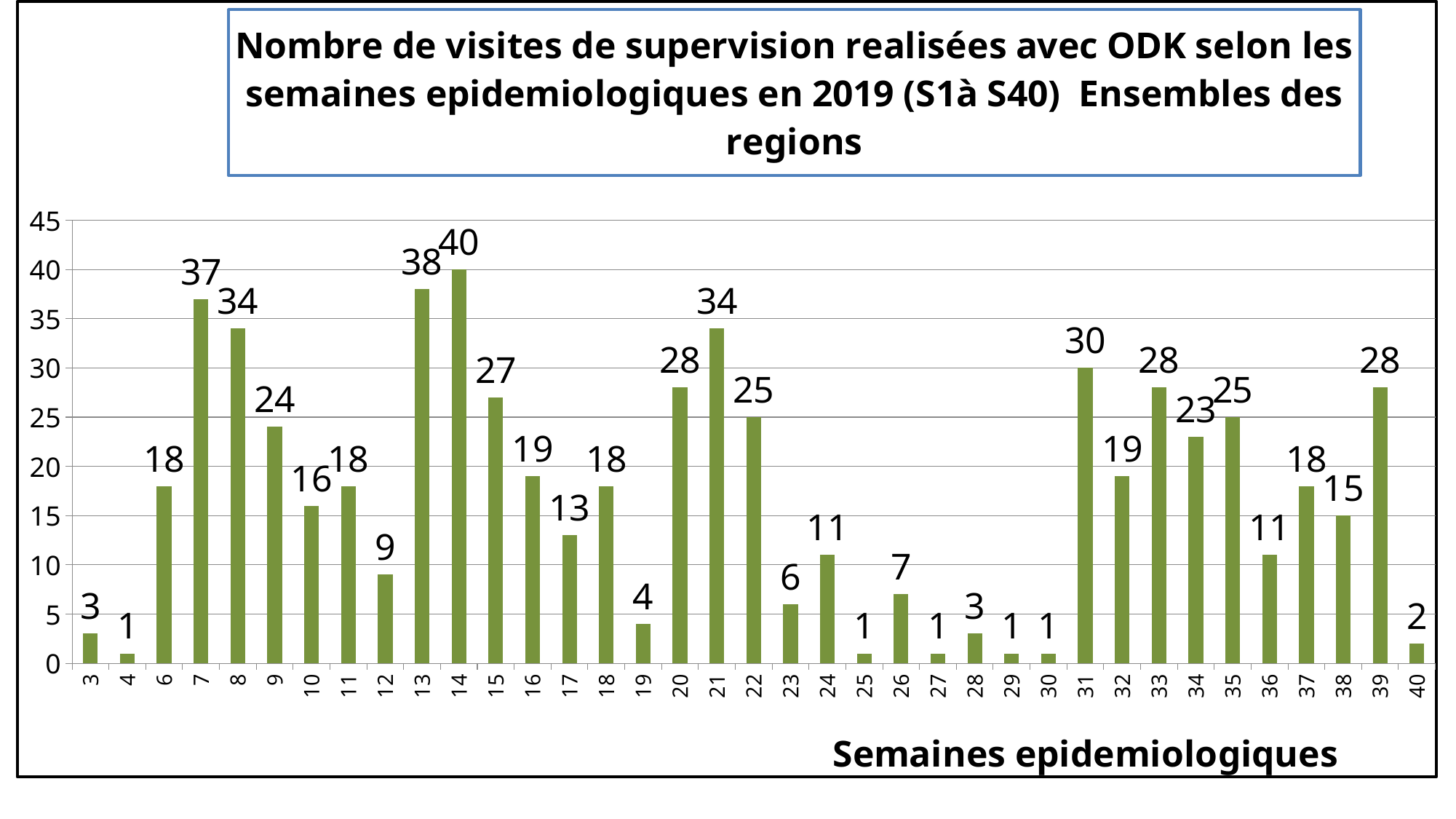
What is the difference between the values for week 39 and week 38? 13 Which has a larger value, week 8 or week 15? week 8 Which epidemiological week has the highest number of supervision visits? 14 How many supervision visits were made in epidemiological week 7? 37 What is the lowest value shown on the chart? 1 Is the value for week 24 greater or less than 15? less What is the value for week 21? 34 What is the value for week 40? 2 What is the value for week 31? 30 What kind of chart is shown on the slide? bar chart What is the difference between the values for week 13 and week 12? 29 How many epidemiological weeks are shown on the x axis? 37